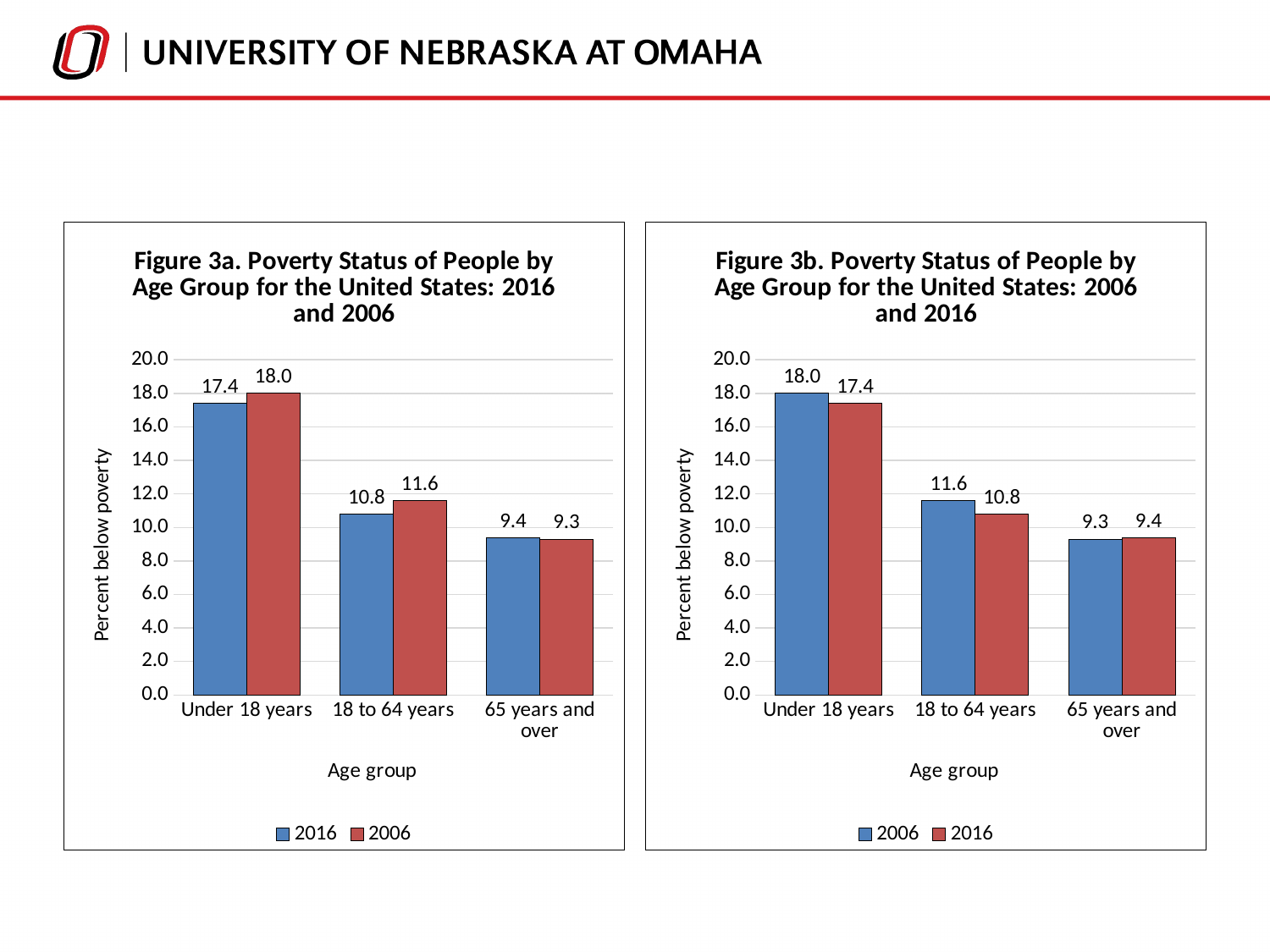
In Figure 3b, what is the difference between the 2006 and 2016 values for 18 to 64 years? 0.8 How many age groups are shown in Figure 3a? 3 In Figure 3b, what is the value for 18 to 64 years in 2006? 11.6 In Figure 3a, which is larger for 18 to 64 years: the 2016 value or the 2006 value? 2006 In Figure 3a, what is the value for Under 18 years in 2016? 17.4 In Figure 3a, which age group has the highest value for 2016? Under 18 years How many series does the legend of Figure 3b list? 2 What type of chart is Figure 3a? Bar chart In Figure 3b, which age group has the lowest value for 2006? 65 years and over In Figure 3a, what is the difference between the 2006 and 2016 values for Under 18 years? 0.6 In Figure 3a, what is the value for 65 years and over in 2006? 9.3 In Figure 3b, is the 2016 value for Under 18 years greater or less than 16.0? greater